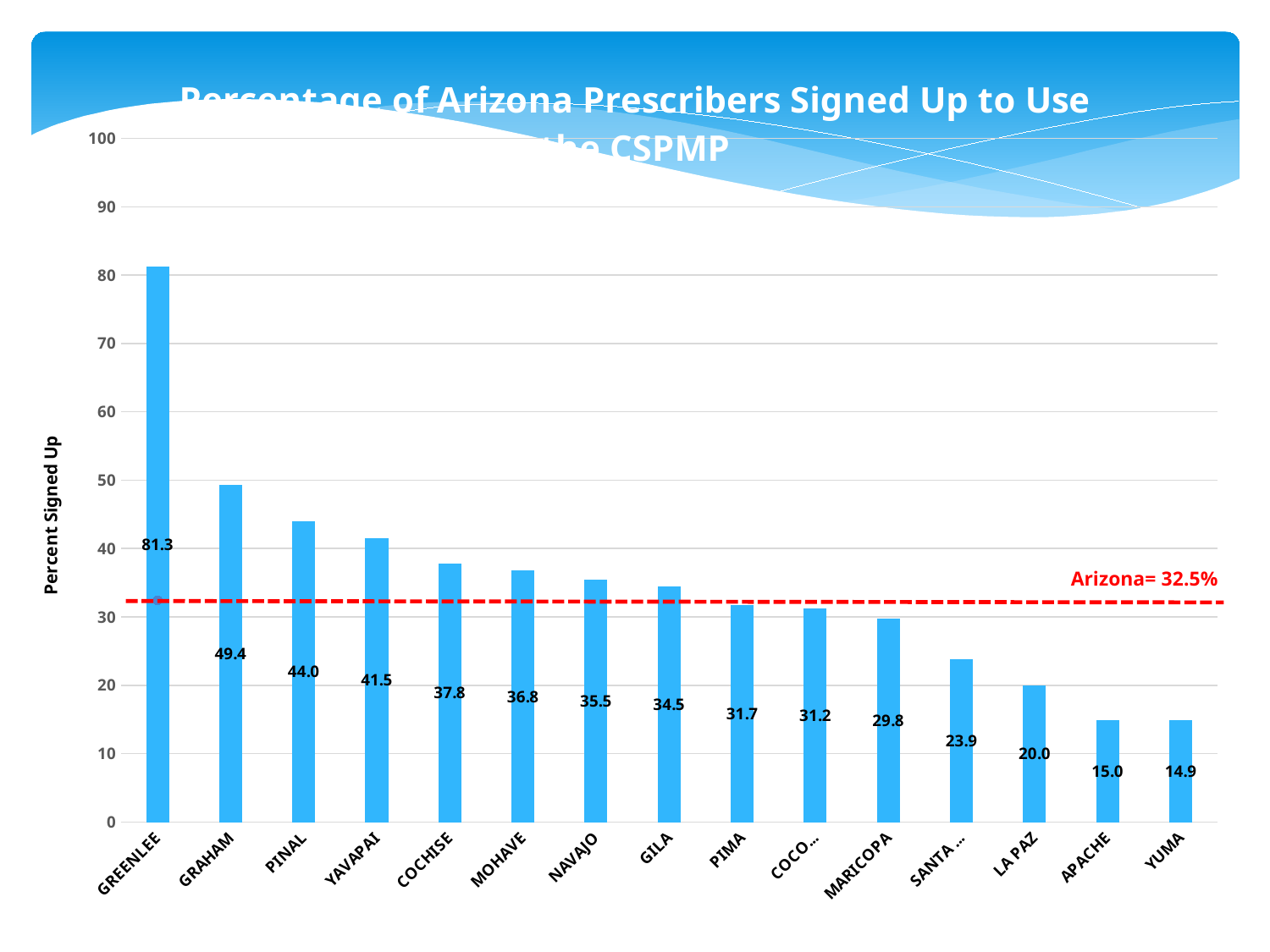
Which county has the lowest percentage signed up? YUMA What is the value for MARICOPA? 29.8 Is the value for YAVAPAI greater or less than 40? greater What value does the red dashed line labelled Arizona represent? 32.5% What kind of chart is shown on the slide? bar chart What is the value for GREENLEE? 81.3 How many counties are shown on the x axis? 15 What is the difference between the values for GRAHAM and PINAL? 5.4 Which county has the highest percentage signed up? GREENLEE Do the values rise or fall from left to right along the x axis? fall What is the value for LA PAZ? 20.0 Which has a larger value, COCHISE or PIMA? COCHISE